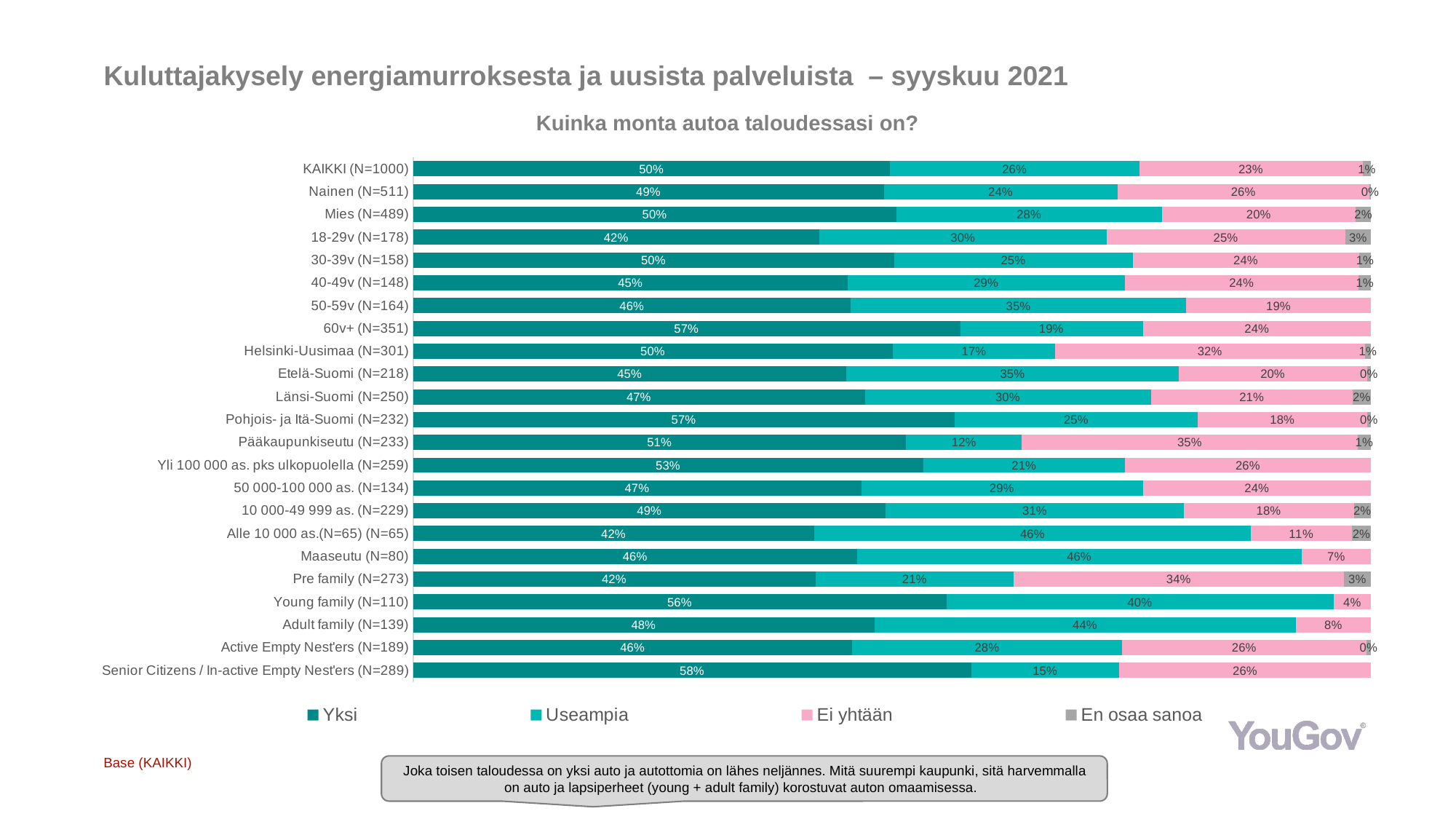
What is the difference between the 'Ei yhtään' values for Helsinki-Uusimaa (N=301) and Pohjois- ja Itä-Suomi (N=232)? 14% How many series does the legend list? 4 Which is larger: the 'Useampia' value for Young family (N=110) or for Pre family (N=273)? Young family (N=110) What is the 'Ei yhtään' value for Pääkaupunkiseutu (N=233)? 35% Which category has the highest 'Yksi' value? Senior Citizens / In-active Empty Nest'ers (N=289) Which category has the lowest 'Ei yhtään' value? Young family (N=110) What is the 'Yksi' value for KAIKKI (N=1000)? 50% What is the title of the chart? Kuinka monta autoa taloudessasi on? How many categories (rows) are shown in the chart? 23 What is the 'En osaa sanoa' value for 18-29v (N=178)? 3% What is the 'Useampia' value for Maaseutu (N=80)? 46% What kind of chart is shown on the slide? Stacked bar chart